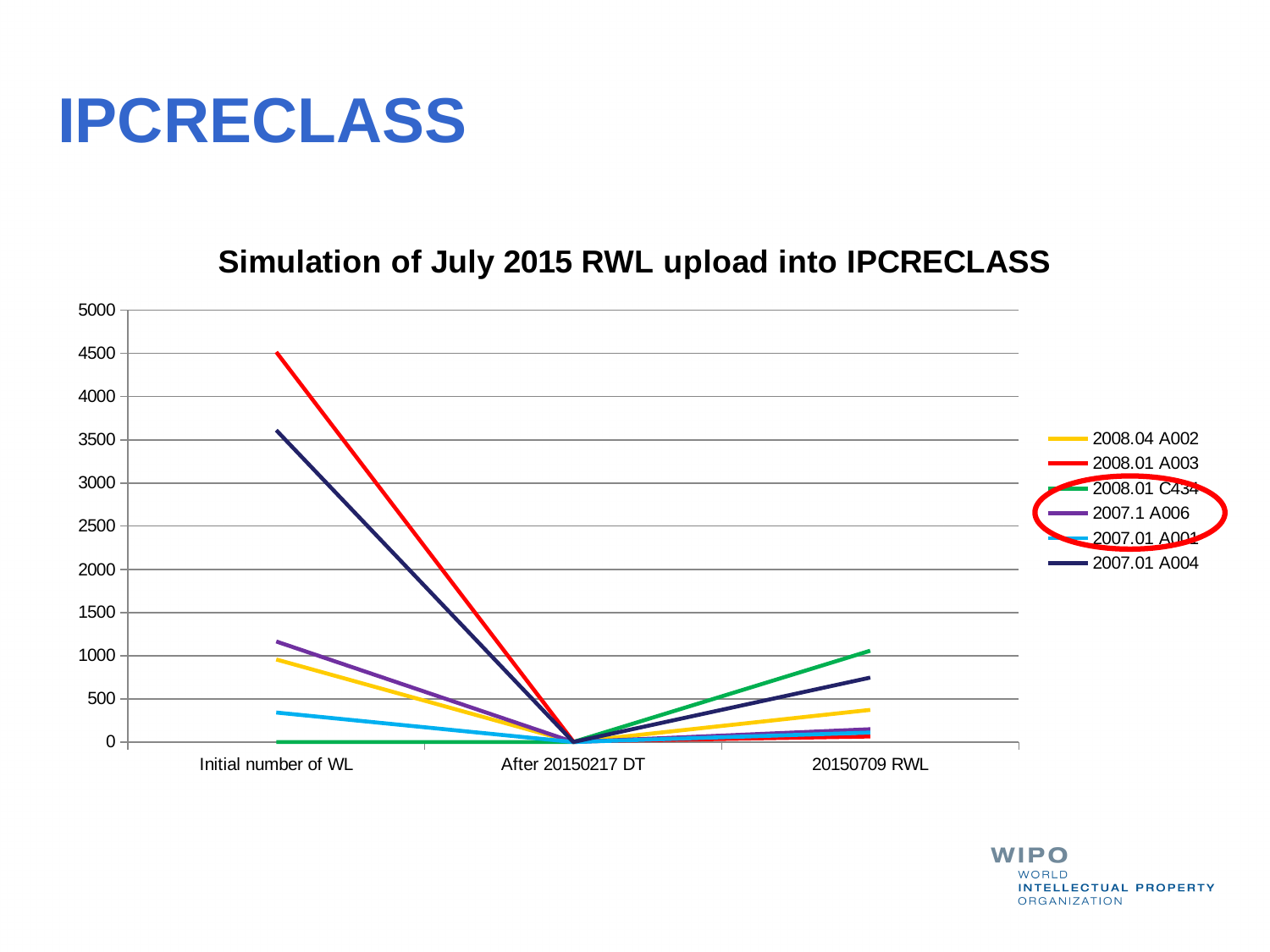
How many categories are shown on the x axis? 3 At "20150709 RWL", which is larger: 2007.01 A004 or 2008.04 A002? 2007.01 A004 What kind of chart is shown on the slide? line chart What is the value of 2008.01 C434 at "Initial number of WL"? 0 Does the 2008.01 A003 line rise or fall from "Initial number of WL" to "After 20150217 DT"? fall Which series has the highest value at "20150709 RWL"? 2008.01 C434 Is the value for 2007.01 A004 at "Initial number of WL" greater or less than 3000? greater What is the value of 2007.01 A004 at "After 20150217 DT"? 0 Is the value for 2007.01 A001 at "Initial number of WL" greater or less than 500? less What is the title of the chart? Simulation of July 2015 RWL upload into IPCRECLASS Which series has the highest value at "Initial number of WL"? 2008.01 A003 How many series does the legend list? 6